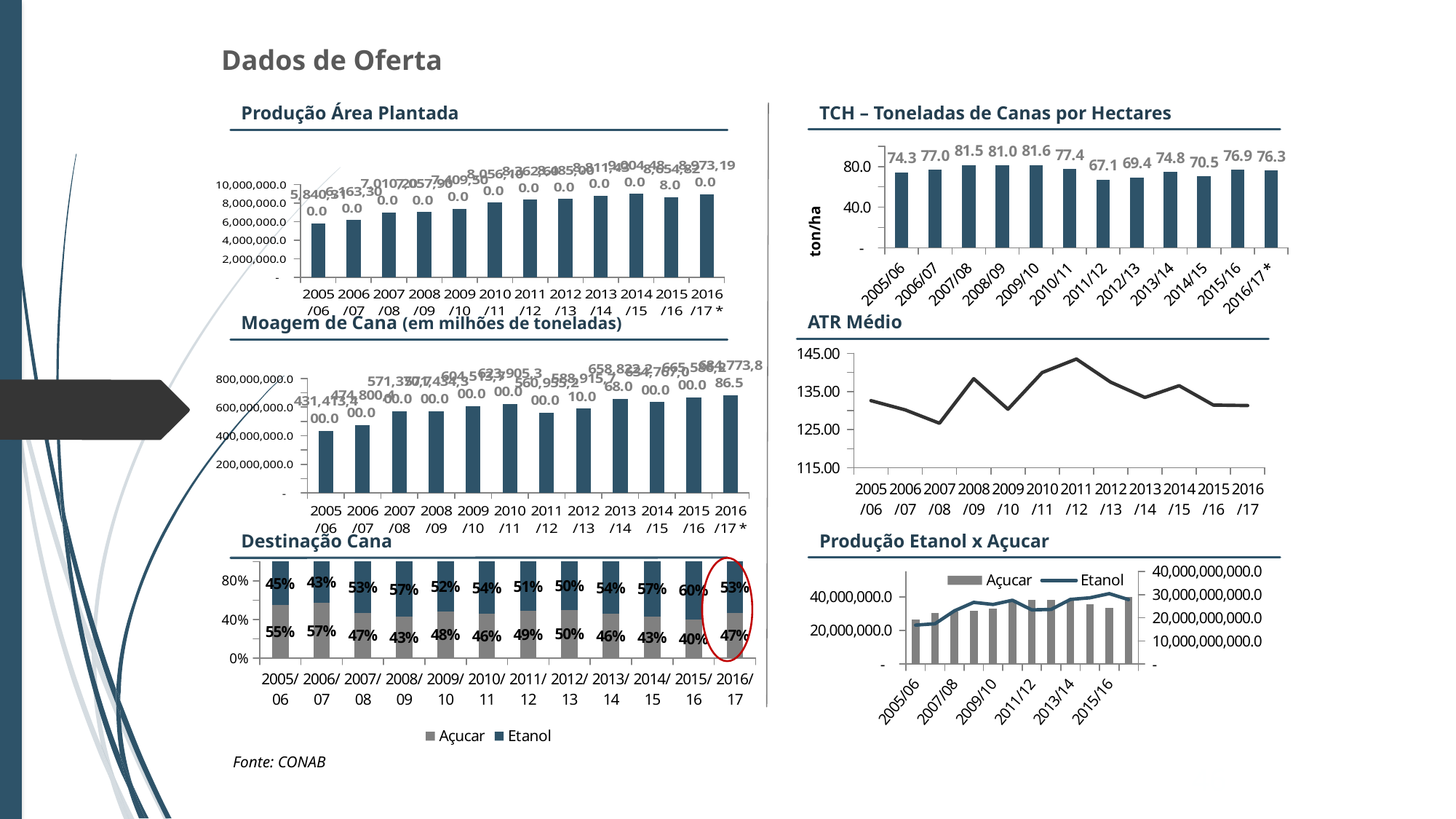
In the TCH – Toneladas de Canas por Hectares chart, what is the difference between the values for 2005/06 and 2006/07? 2.7 In the TCH – Toneladas de Canas por Hectares chart, what is the value for 2007/08? 81.5 In the ATR Médio chart, is the value for 2007/08 greater or less than 135.00? less In the TCH – Toneladas de Canas por Hectares chart, which year has the highest value? 2009/10 In the Produção Etanol x Açucar chart, how many series does the legend list? 2 In the Destinação Cana chart, which is larger for 2008/09, the Açucar share or the Etanol share? Etanol In the Destinação Cana chart, what is the Etanol share for 2015/16? 60% In the ATR Médio chart, which year has the highest value? 2011/12 In the TCH – Toneladas de Canas por Hectares chart, which year has the lowest value? 2011/12 In the Destinação Cana chart, which year has the lowest Açucar share? 2015/16 In the TCH – Toneladas de Canas por Hectares chart, how many years are shown? 12 In the Destinação Cana chart, what is the Açucar share for 2005/06? 55%